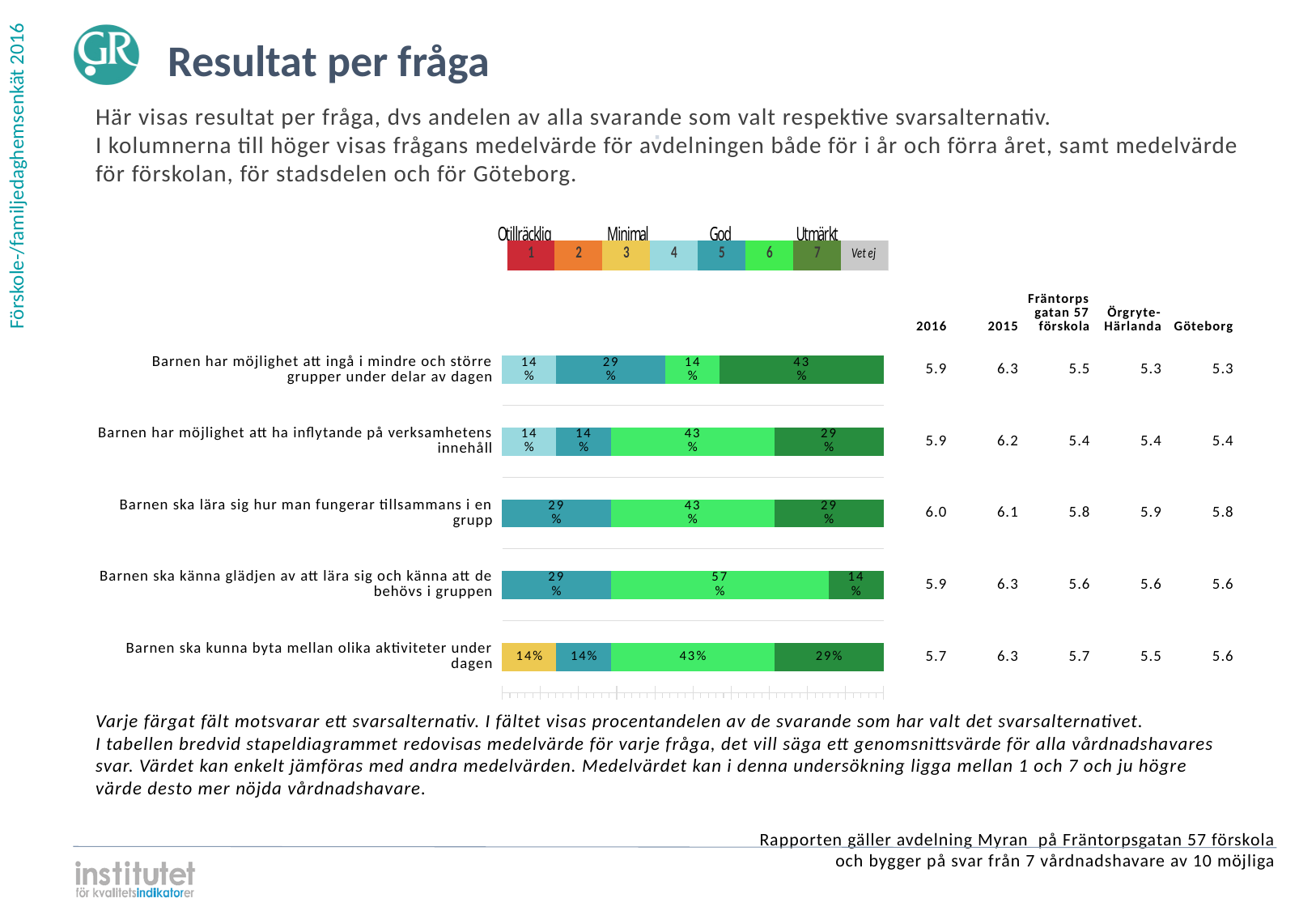
What percentage of respondents chose answer 7 (Utmärkt) for 'Barnen har möjlighet att ingå i mindre och större grupper under delar av dagen'? 43% For 'Barnen har möjlighet att ha inflytande på verksamhetens innehåll', which is larger: the share for answer 6 or the share for answer 7? Answer 6 What percentage of respondents chose answer 3 for 'Barnen ska kunna byta mellan olika aktiviteter under dagen'? 14% What kind of chart is used to show the results per question? Stacked bar chart How many answer alternatives does the legend above the chart list? 8 What is the total of the segments in the bar for 'Barnen har möjlighet att ingå i mindre och större grupper under delar av dagen'? 100% How many questions (categories) are shown in the bar chart? 5 Which answer alternative has the largest share for 'Barnen ska lära sig hur man fungerar tillsammans i en grupp'? 6 What colour represents answer alternative 7 (Utmärkt) in the legend? Dark green What percentage of respondents chose answer 6 for 'Barnen ska känna glädjen av att lära sig och känna att de behövs i gruppen'? 57% What is the difference between the share for answer 6 and the share for answer 7 in 'Barnen ska känna glädjen av att lära sig och känna att de behövs i gruppen'? 43% What is the 2016 mean value for 'Barnen ska lära sig hur man fungerar tillsammans i en grupp'? 6.0